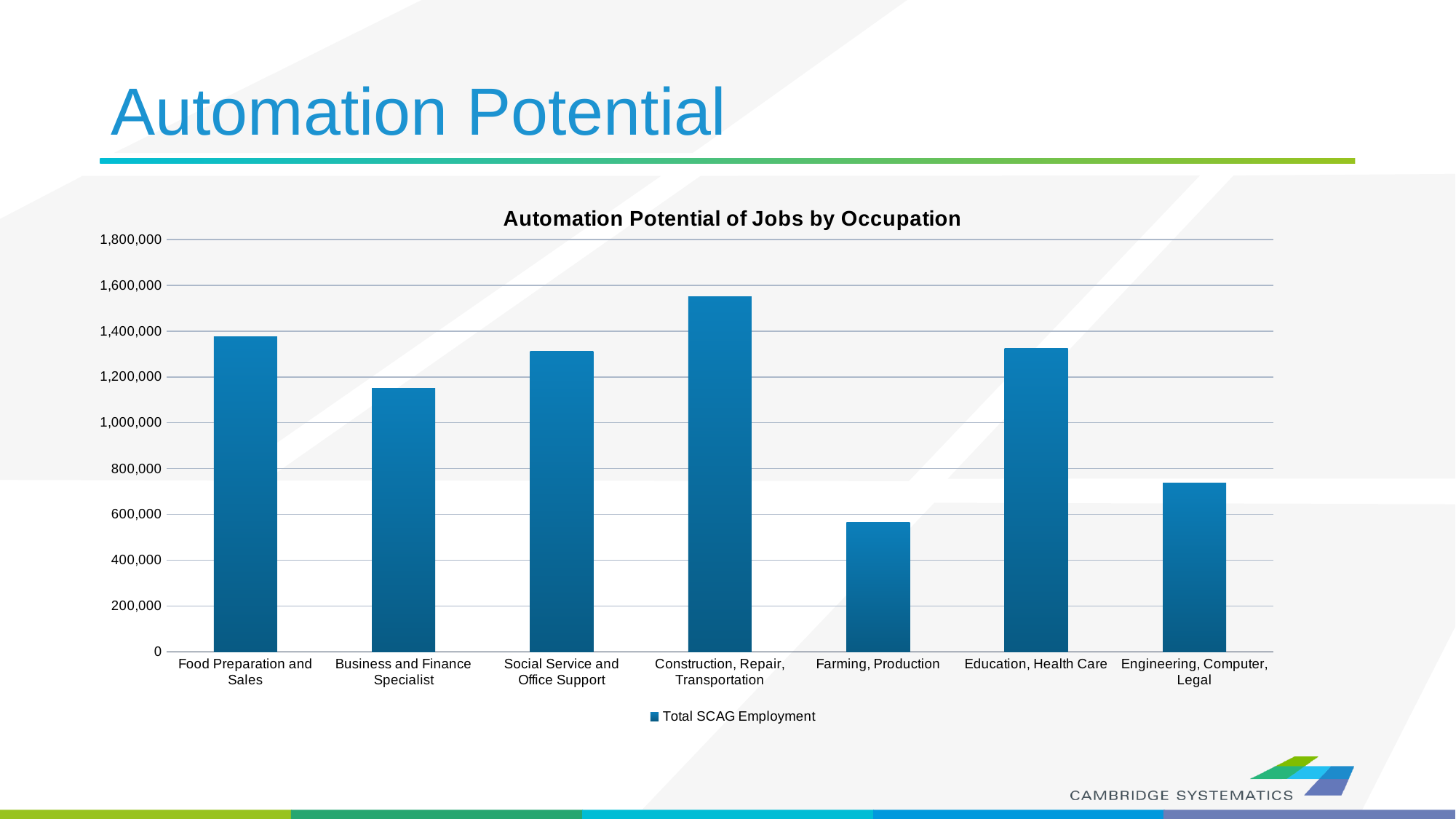
Is the value for Farming, Production greater or less than 600,000? less Is the value for Business and Finance Specialist greater or less than 1,200,000? less What series name is shown in the legend? Total SCAG Employment Which occupation category has the highest Total SCAG Employment? Construction, Repair, Transportation Is the value for Construction, Repair, Transportation greater or less than 1,400,000? greater How many occupation categories are shown on the x axis? 7 What type of chart is shown on the slide? bar chart Which is larger, the value for Food Preparation and Sales or the value for Business and Finance Specialist? Food Preparation and Sales How many series does the legend list? 1 Which occupation category has the lowest Total SCAG Employment? Farming, Production What is the title of the chart? Automation Potential of Jobs by Occupation